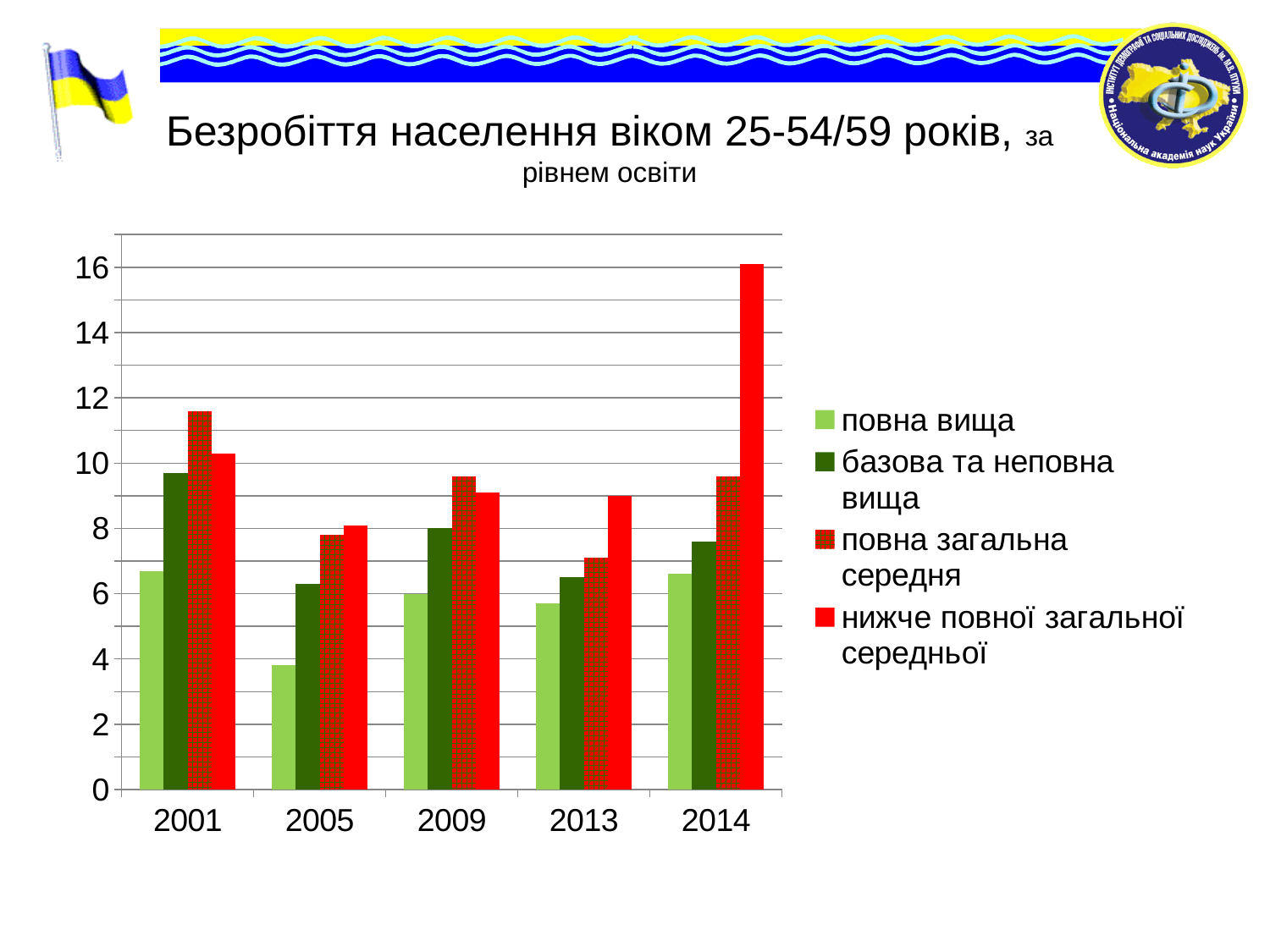
In which year is the value for "нижче повної загальної середньої" highest? 2014 Is the value for "повна вища" in 2005 greater or less than 6? less Is the value for "нижче повної загальної середньої" in 2014 greater or less than 14? greater How many series does the legend list? 4 What kind of chart is shown on the slide? bar chart Which education level has the highest unemployment value in 2014? нижче повної загальної середньої In 2001, which is larger: "повна загальна середня" or "нижче повної загальної середньої"? повна загальна середня Is the value for "повна загальна середня" in 2001 greater or less than 10? greater Which education level has the lowest value in every year shown? повна вища In which year is the value for "повна вища" lowest? 2005 How many years are shown on the x axis? 5 Which colour represents "повна вища" in the legend? light green